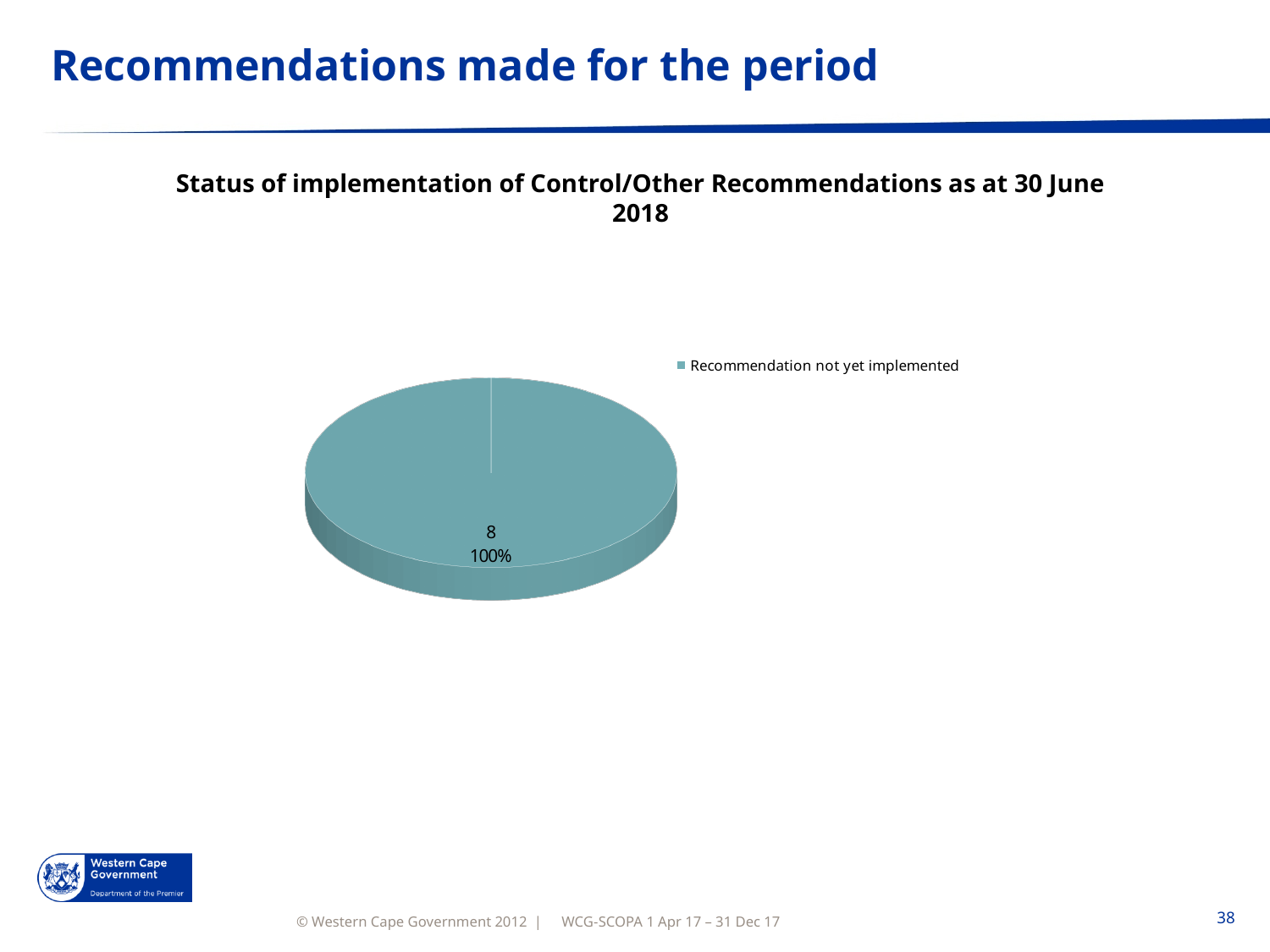
Is the value for "Recommendation not yet implemented" greater or less than 5? greater What is the only category named in the chart legend? Recommendation not yet implemented What share of the pie does "Recommendation not yet implemented" represent? 100% How many slices does the pie chart have? 1 How many entries does the legend list? 1 What kind of chart is shown on the slide? Pie chart What is the title of the chart? Status of implementation of Control/Other Recommendations as at 30 June 2018 What is the value shown for "Recommendation not yet implemented"? 8